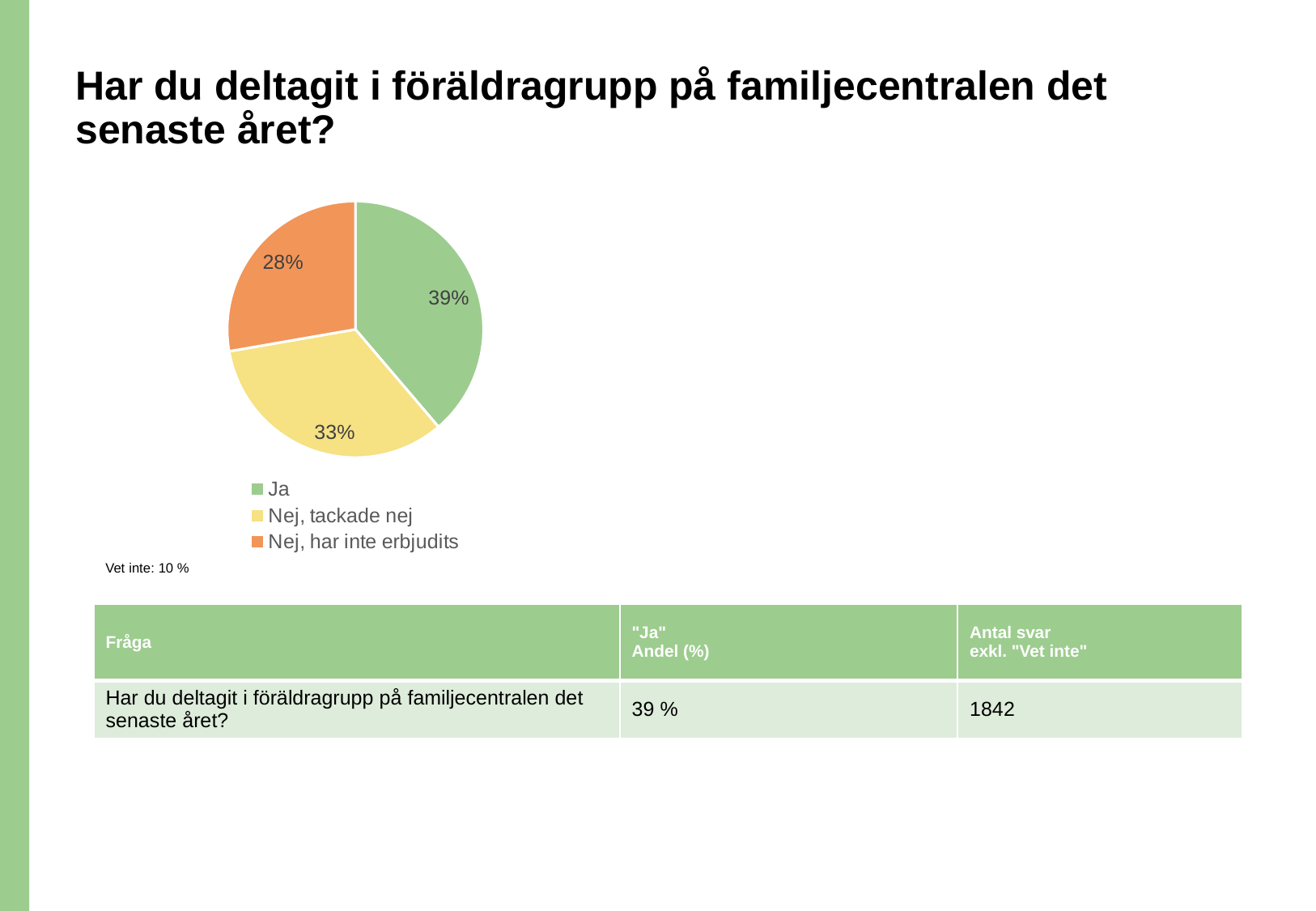
How many slices does the pie chart have? 3 What share of the pie does "Nej, tackade nej" have? 33% Which slice of the pie is the largest? Ja Which slice of the pie is the smallest? Nej, har inte erbjudits What share of the pie does "Ja" have? 39% How many entries does the legend list? 3 Which is larger, the "Ja" slice or the "Nej, tackade nej" slice? Ja What kind of chart is shown on the slide? pie chart What is the difference in percentage points between the "Nej, tackade nej" slice and the "Nej, har inte erbjudits" slice? 5 What colour is the "Nej, har inte erbjudits" slice? orange What is the difference in percentage points between the "Ja" slice and the "Nej, har inte erbjudits" slice? 11 What share of the pie does "Nej, har inte erbjudits" have? 28%